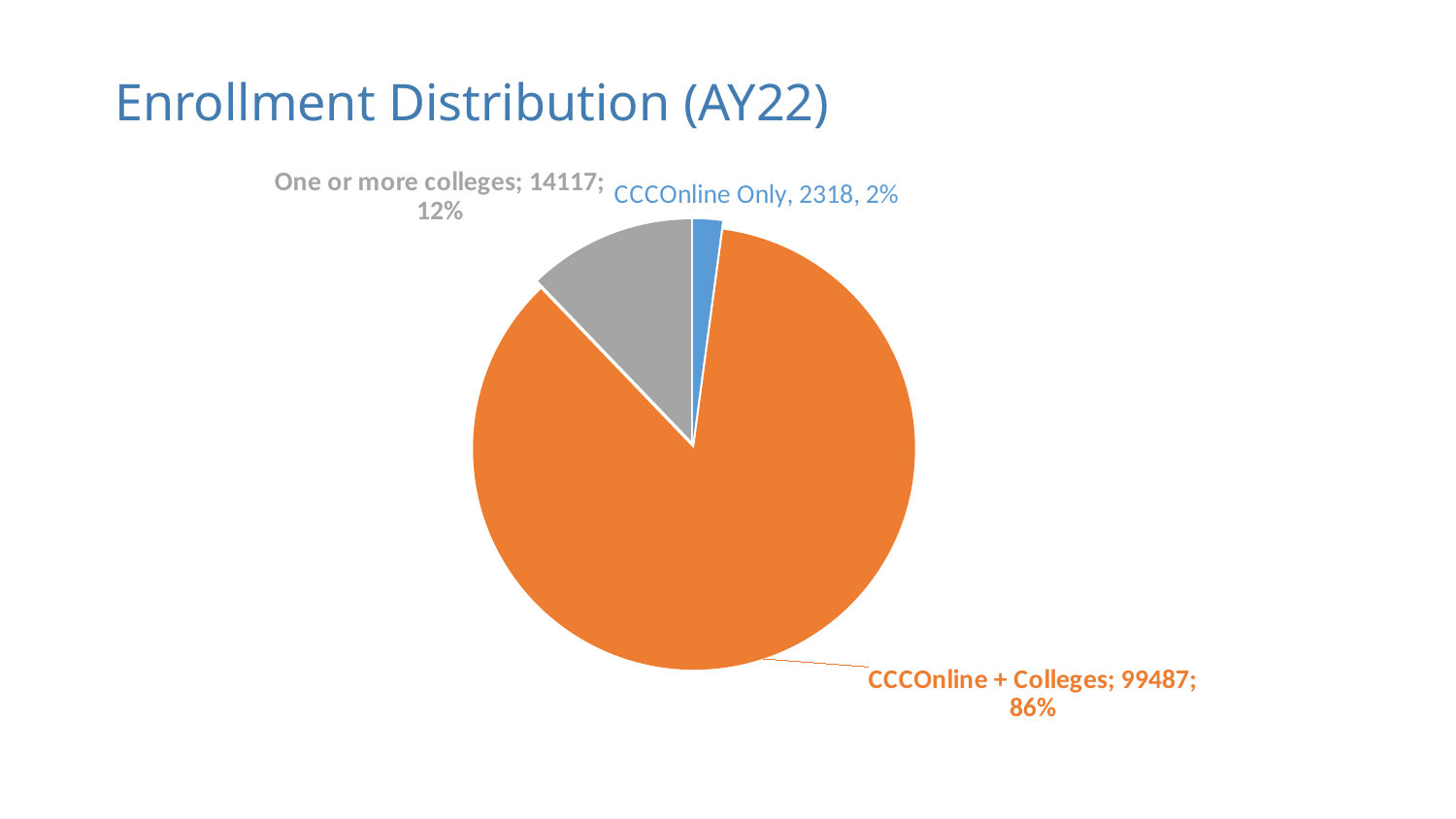
What is the enrollment value for CCCOnline Only? 2318 How many categories are shown in the pie chart? 3 Which category has the largest slice of the pie? CCCOnline + Colleges Which category has the smallest slice of the pie? CCCOnline Only What is the enrollment value for One or more colleges? 14117 What share of the pie does One or more colleges represent? 12% What kind of chart is shown on the slide? pie chart What is the title of the slide? Enrollment Distribution (AY22) What is the difference between the values for One or more colleges and CCCOnline Only? 11799 What share of the pie does CCCOnline + Colleges represent? 86% Which is larger, the value for One or more colleges or the value for CCCOnline Only? One or more colleges What is the enrollment value for CCCOnline + Colleges? 99487